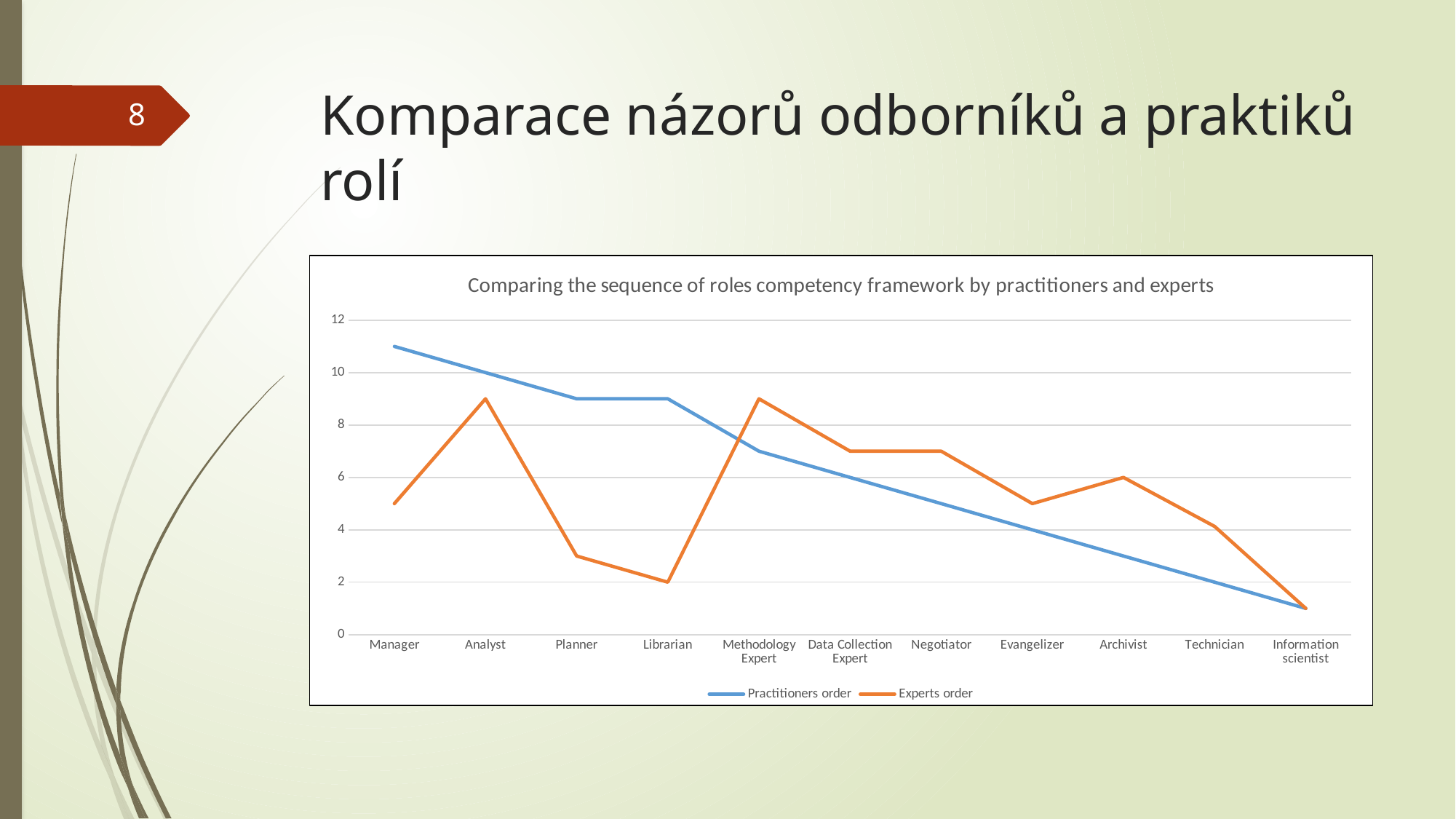
What is the Practitioners order value for Technician? 2 How many series does the chart legend list? 2 At Methodology Expert, which series has the higher value, Practitioners order or Experts order? Experts order What kind of chart is shown on the slide? line chart How many roles are plotted along the x axis of the chart? 11 Is the Practitioners order value for Manager greater or less than 10? greater What is the title of the chart? Comparing the sequence of roles competency framework by practitioners and experts What is the Practitioners order value for Analyst? 10 Which role has the highest Practitioners order value? Manager Is the Experts order value for Planner greater or less than 4? less What is the Experts order value for Librarian? 2 What is the Experts order value for Archivist? 6